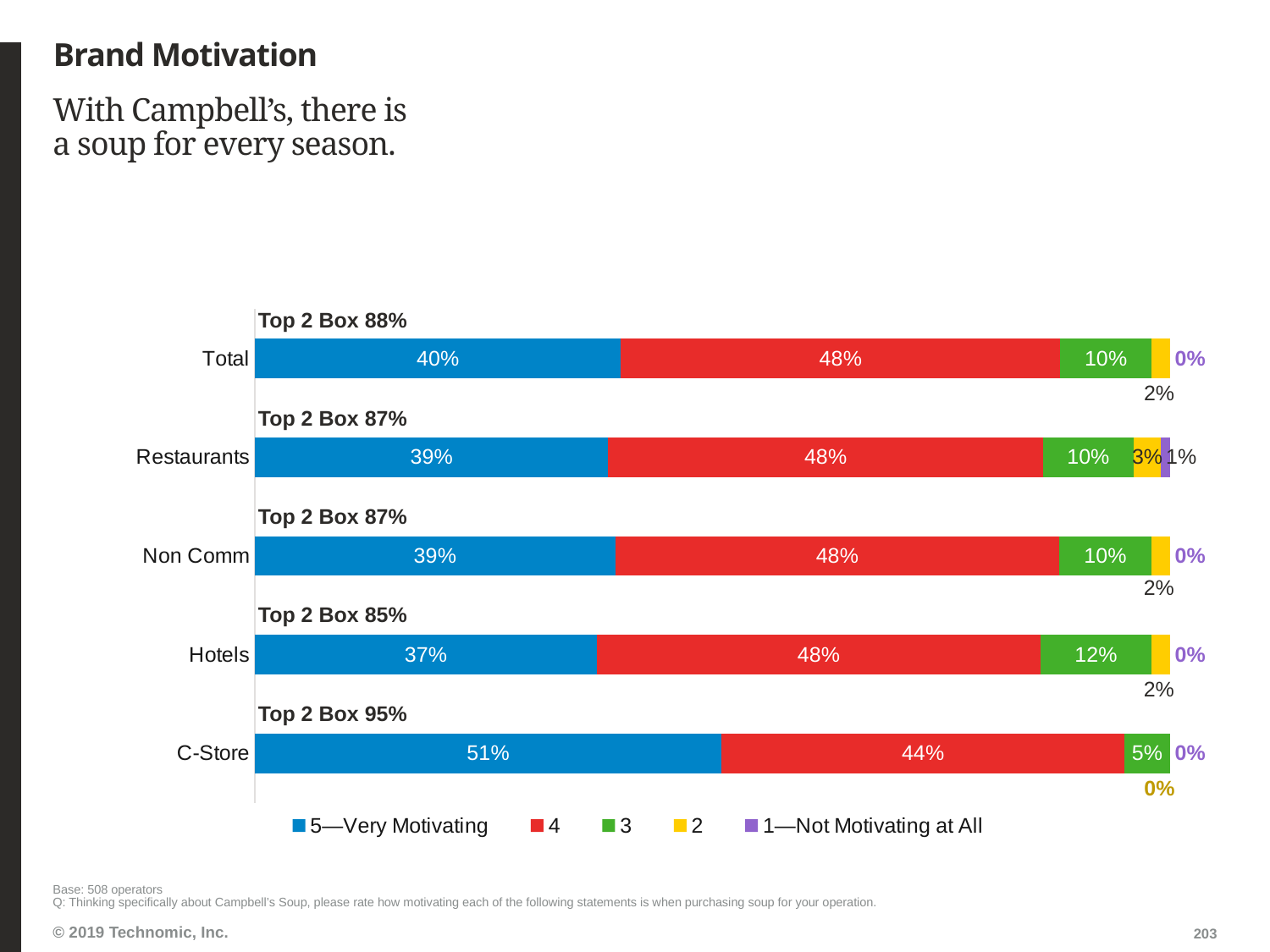
What percentage of C-Store operators rated the statement 5—Very Motivating? 51% What kind of chart is shown on the slide? Stacked bar chart How many categories are shown on the chart? 5 What is the value for the 1—Not Motivating at All rating among Restaurants? 1% Which legend entry is shown in blue? 5—Very Motivating How many series does the legend list? 5 Which is larger: the 4 rating share for C-Store or for Hotels? Hotels What is the difference between the 5—Very Motivating share for C-Store and for Total? 11% Which category has the highest share of 5—Very Motivating responses? C-Store Which category has the lowest share of 5—Very Motivating responses? Hotels What is the Top 2 Box value shown for Restaurants? 87% What is the value for the 3 rating among Hotels? 12%